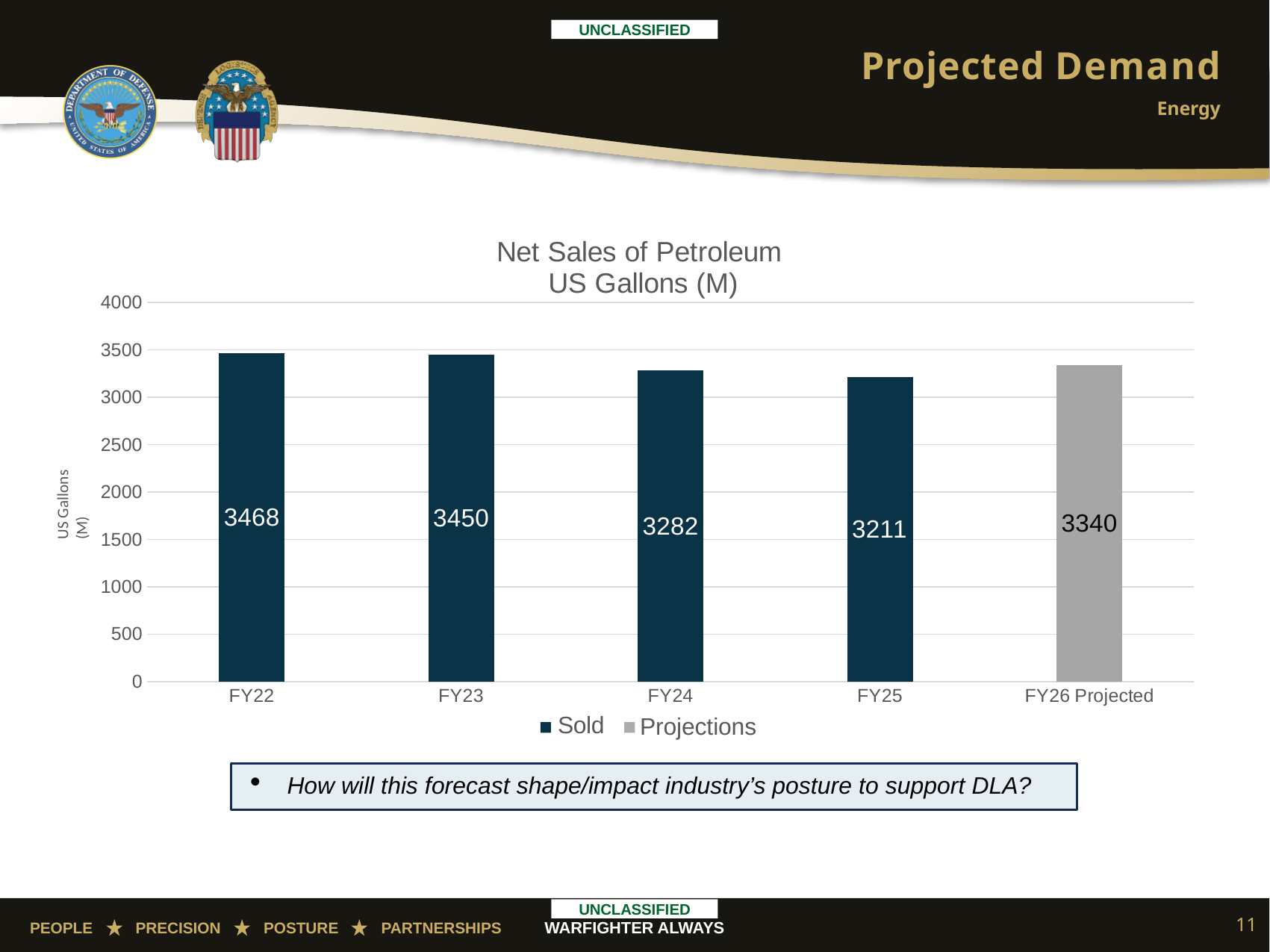
What is the value for FY25 in the Net Sales of Petroleum chart? 3211 How many fiscal years are shown on the x axis of the chart? 5 What is the projected value for FY26 in the Net Sales of Petroleum chart? 3340 Which fiscal year has the highest net sales of petroleum? FY22 Do the values for the Sold series rise or fall from FY22 to FY25? Fall What kind of chart is shown on the slide? Bar chart What is the difference between the FY22 and FY25 values? 257 How many series does the legend list? 2 What is the difference between the FY26 Projected value and the FY25 value? 129 Which is larger, the value for FY24 or the value for FY26 Projected? FY26 Projected Which fiscal year has the lowest net sales of petroleum? FY25 What is the value for FY22 in the Net Sales of Petroleum chart? 3468